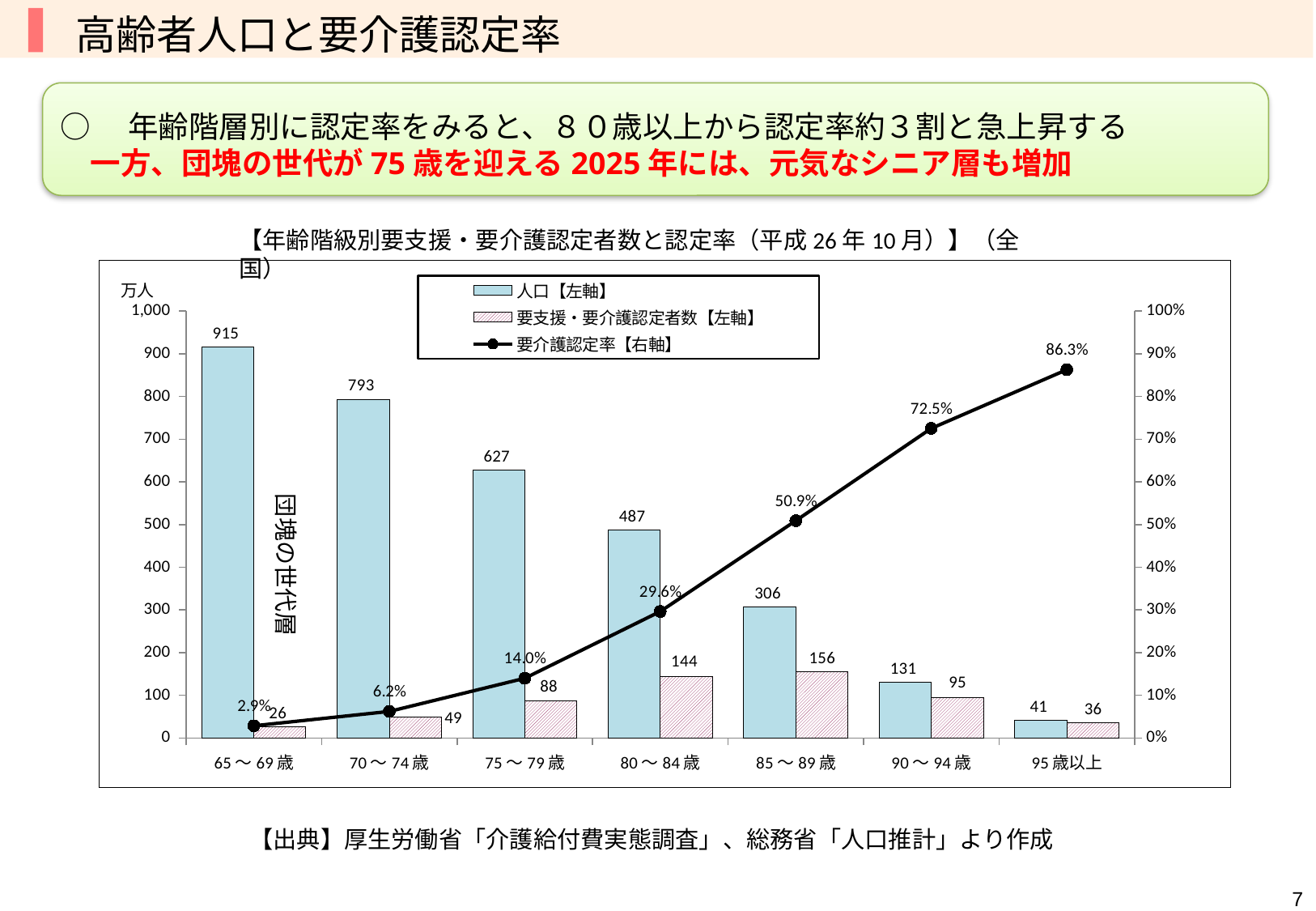
What is the unit label shown on the left axis? 万人 How many age groups are shown on the x axis? 7 Does the 要介護認定率 line rise or fall as age increases along the x axis? rises What is the 要介護認定率 for the 80～84歳 age group? 29.6% Which age group has the highest 要介護認定率? 95歳以上 What is the 要支援・要介護認定者数 value for the 85～89歳 age group? 156 How many series does the legend list? 3 What is the difference between the population values for 65～69歳 and 70～74歳? 122 What is the 要介護認定率 for the 90～94歳 age group? 72.5% Which age group has the lowest population (人口) value? 95歳以上 Which is larger: the 要支援・要介護認定者数 for 80～84歳 or for 90～94歳? 80～84歳 What is the population (人口) value for the 65～69歳 age group? 915